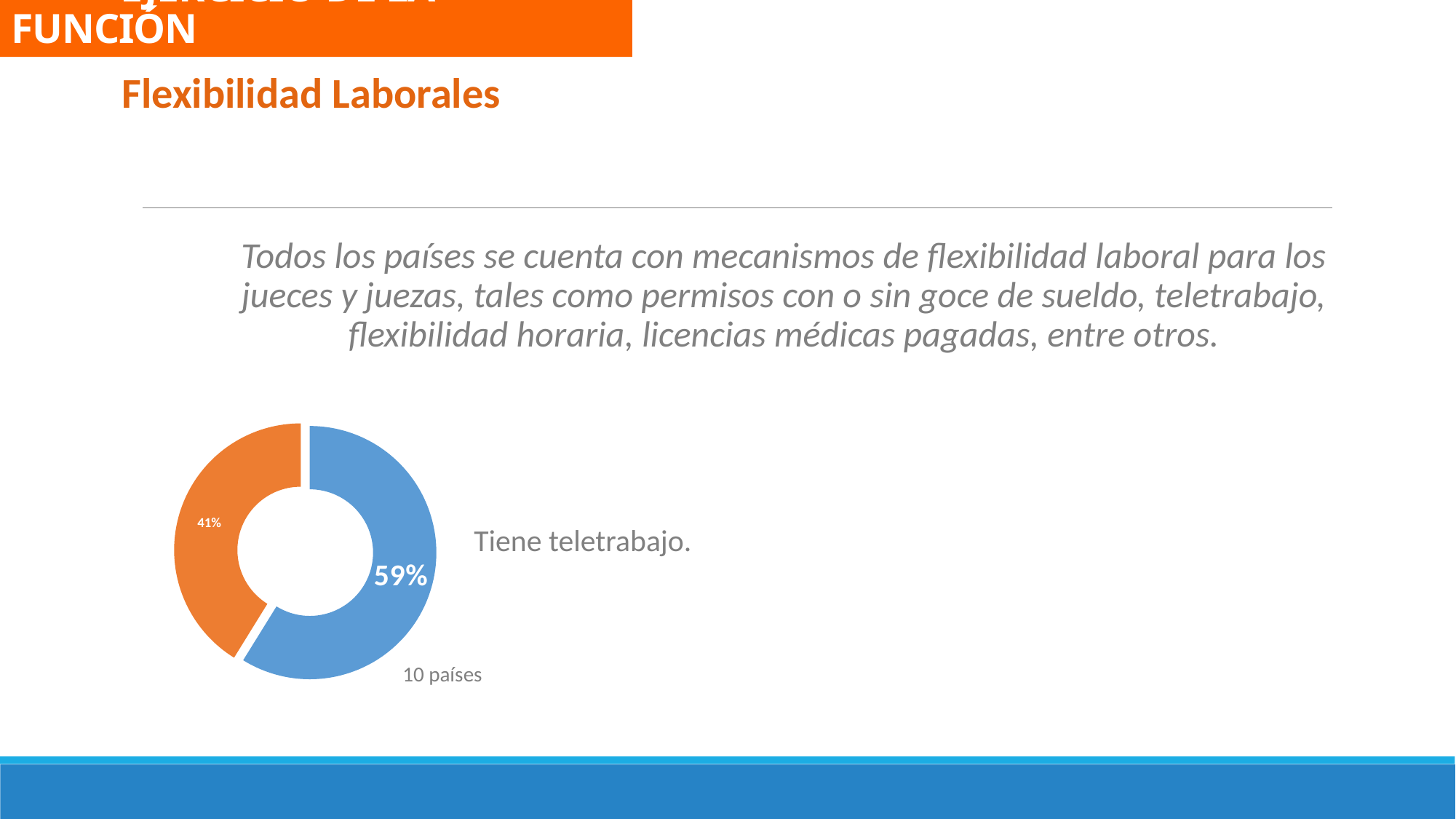
What is the total of the two percentages shown on the doughnut chart? 100% How many slices does the doughnut chart have? 2 Is the share of the blue slice greater or less than 50%? greater What is the difference in percentage points between the blue slice and the orange slice? 18 percentage points Which slice of the doughnut chart is larger, the blue one or the orange one? The blue one Is the share of the orange slice greater or less than 50%? less What percentage is shown on the blue slice of the doughnut chart? 59% What kind of chart is shown on the slide? Doughnut (pie) chart What annotation appears below the doughnut chart? 10 países What text label appears next to the 59% slice of the doughnut chart? Tiene teletrabajo. What percentage is shown on the orange slice of the doughnut chart? 41%